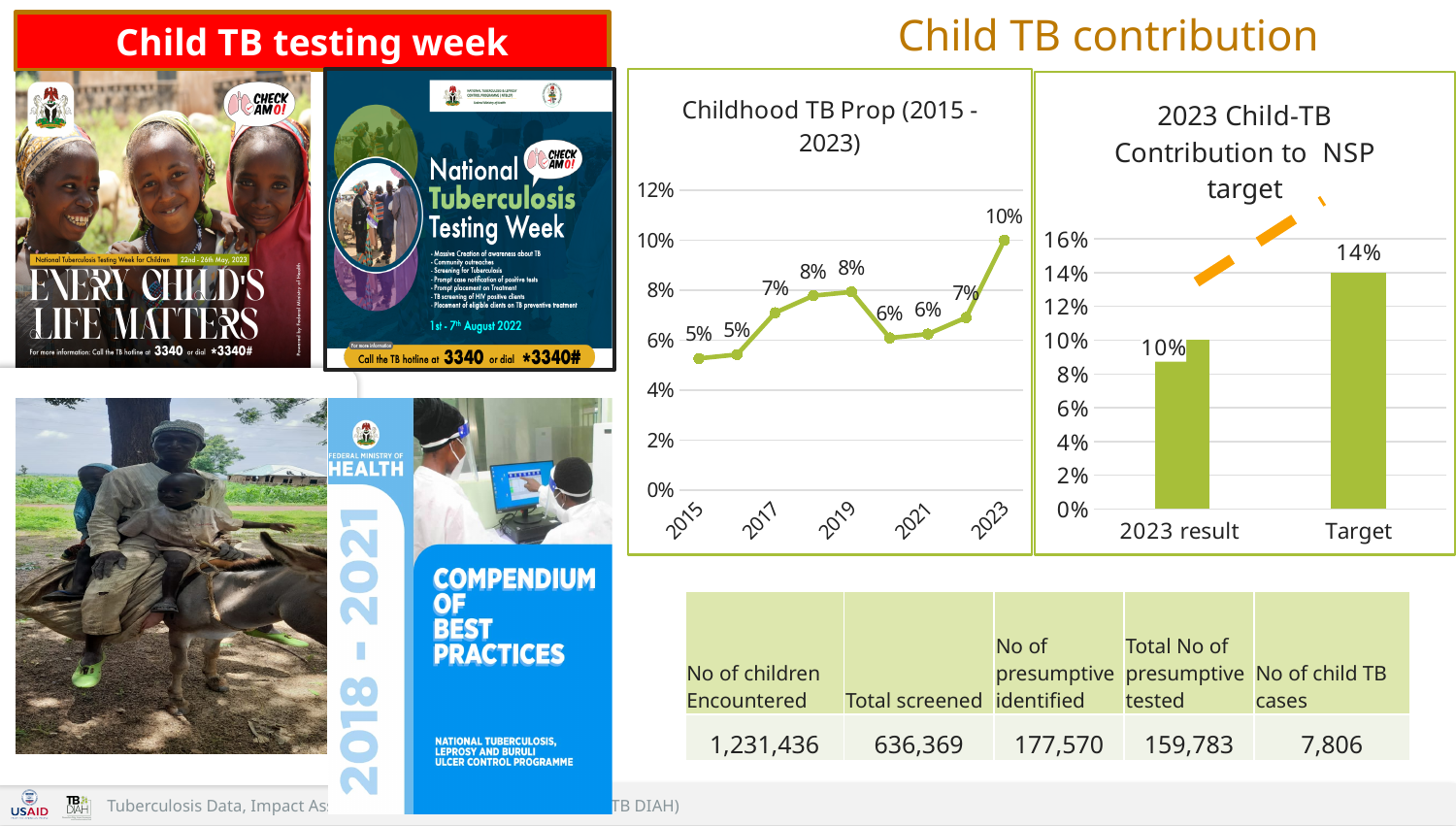
How many data points are plotted in the 'Childhood TB Prop (2015 - 2023)' chart? 9 In the 'Childhood TB Prop (2015 - 2023)' chart, what is the value for 2015? 5% How many bars are shown in the '2023 Child-TB Contribution to NSP target' chart? 2 What kind of chart is the '2023 Child-TB Contribution to NSP target' chart? Bar chart In the '2023 Child-TB Contribution to NSP target' chart, what is the difference between the Target and the 2023 result? 4 percentage points What kind of chart is the 'Childhood TB Prop (2015 - 2023)' chart? Line chart In the '2023 Child-TB Contribution to NSP target' chart, which is larger, the 2023 result or the Target? Target In the 'Childhood TB Prop (2015 - 2023)' chart, what is the difference between the 2023 value and the 2015 value? 5 percentage points In the 'Childhood TB Prop (2015 - 2023)' chart, what is the value for 2023? 10% In the '2023 Child-TB Contribution to NSP target' chart, what is the value for 'Target'? 14% In the 'Childhood TB Prop (2015 - 2023)' chart, which year has the highest value? 2023 In the '2023 Child-TB Contribution to NSP target' chart, what is the value for '2023 result'? 10%